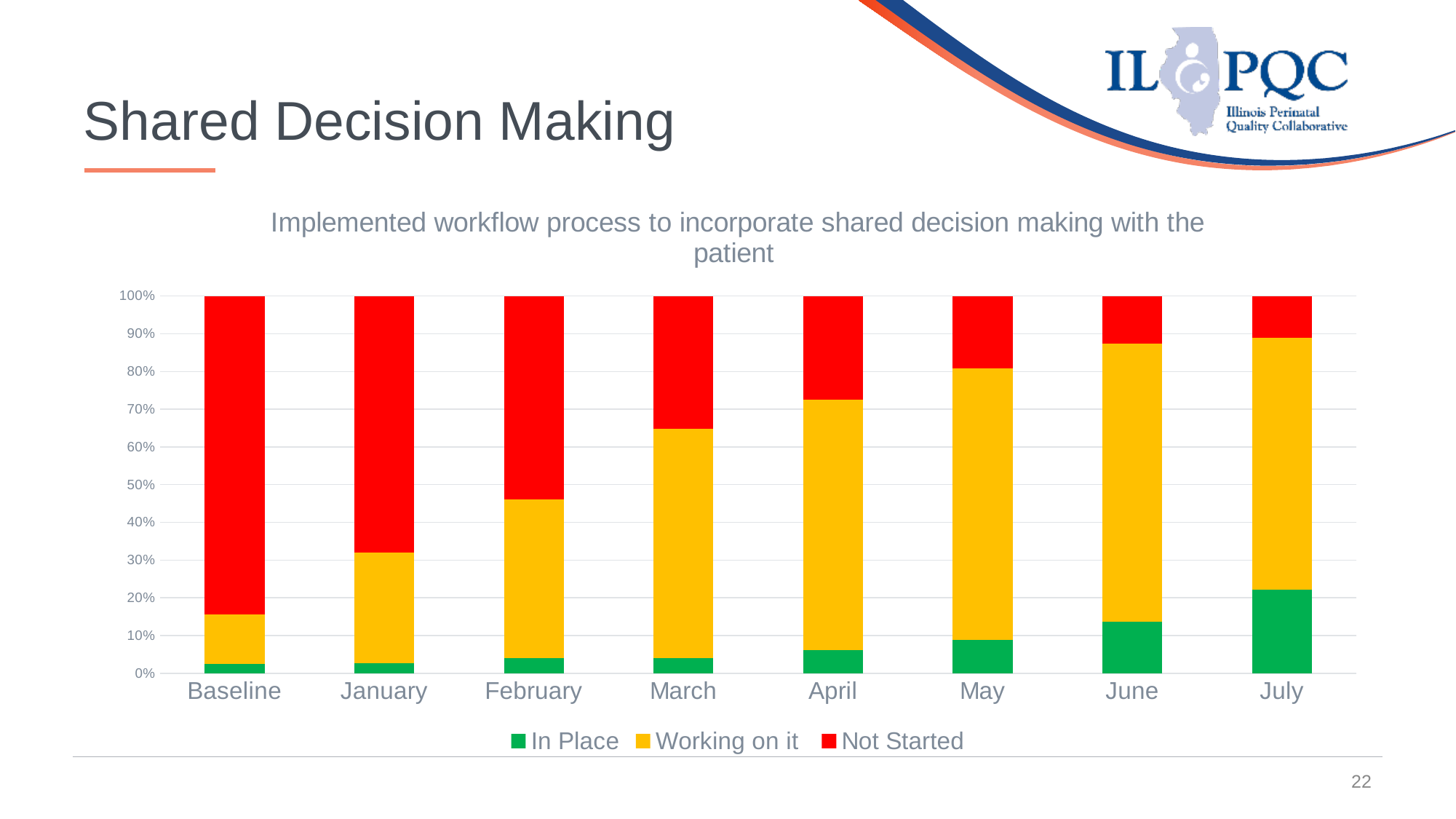
What is the title of the chart? Implemented workflow process to incorporate shared decision making with the patient How many series does the legend list? 3 Does the In Place share rise or fall from Baseline to July? Rise How many categories are shown along the x axis? 8 Is the In Place share for July greater or less than 10%? greater Which series is shown in green in the legend? In Place In which category is the In Place share the largest? July What kind of chart is shown on the slide? Stacked bar chart In which category is the Not Started share the smallest? July Is the Not Started share for Baseline greater or less than 80%? greater Does the Not Started share rise or fall from Baseline to July? Fall In which category is the Not Started share the largest? Baseline